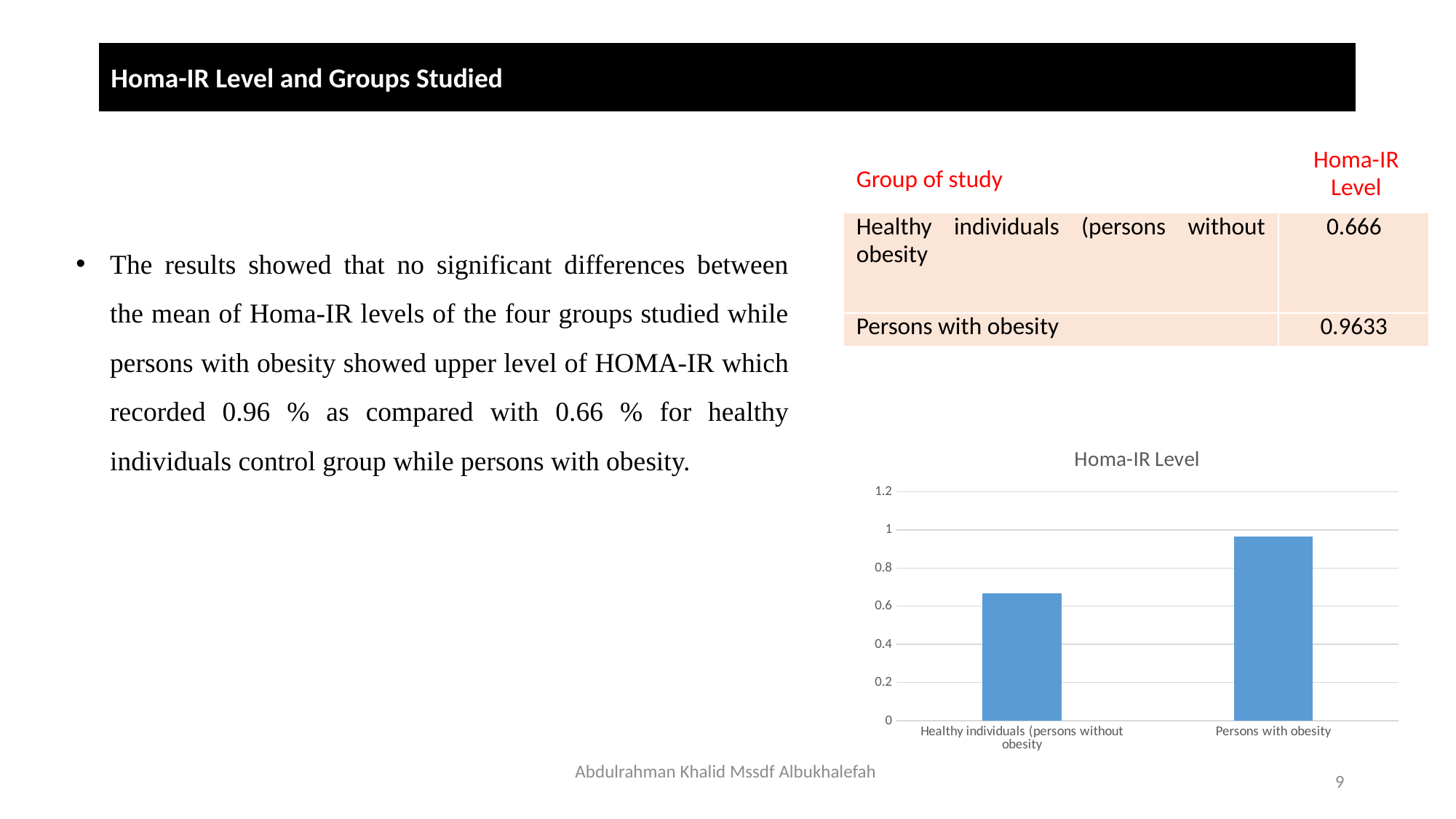
Is the Homa-IR level for Persons with obesity greater or less than 0.8? greater Is the Homa-IR level for Healthy individuals (persons without obesity greater or less than 0.8? less What is the title of the chart? Homa-IR Level Which is larger, the Homa-IR level for Persons with obesity or for Healthy individuals (persons without obesity? Persons with obesity Which group has the highest Homa-IR level in the chart? Persons with obesity Which group has the lowest Homa-IR level in the chart? Healthy individuals (persons without obesity Do the Homa-IR levels rise or fall from the first category to the second along the x axis? rise According to the slide, what is the Homa-IR level for Persons with obesity? 0.9633 What type of chart is shown on the slide? bar chart Is the Homa-IR level for Persons with obesity greater or less than 1? less How many categories are plotted in the chart? 2 According to the slide, what is the Homa-IR level for Healthy individuals (persons without obesity? 0.666